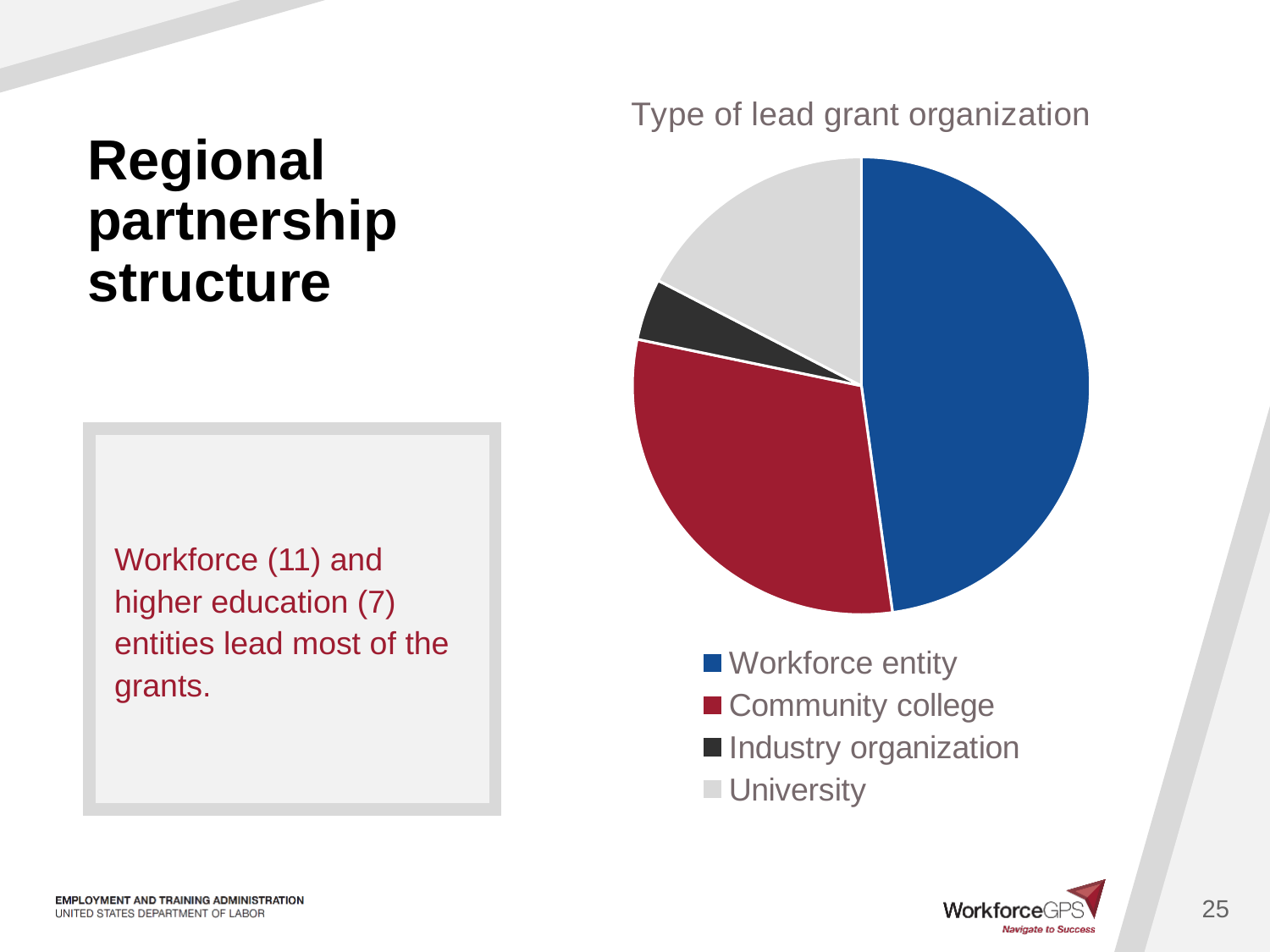
What kind of chart is shown on the slide? pie chart Which legend entry is shown in blue? Workforce entity Which slice is larger, Workforce entity or Community college? Workforce entity How many entries does the chart legend list? 4 Which type of lead grant organization has the largest slice of the pie? Workforce entity How many slices does the pie chart have? 4 Which type of lead grant organization has the smallest slice of the pie? Industry organization Which type of lead grant organization has the second-largest slice of the pie? Community college Which slice is larger, Community college or University? Community college What is the title of the chart? Type of lead grant organization